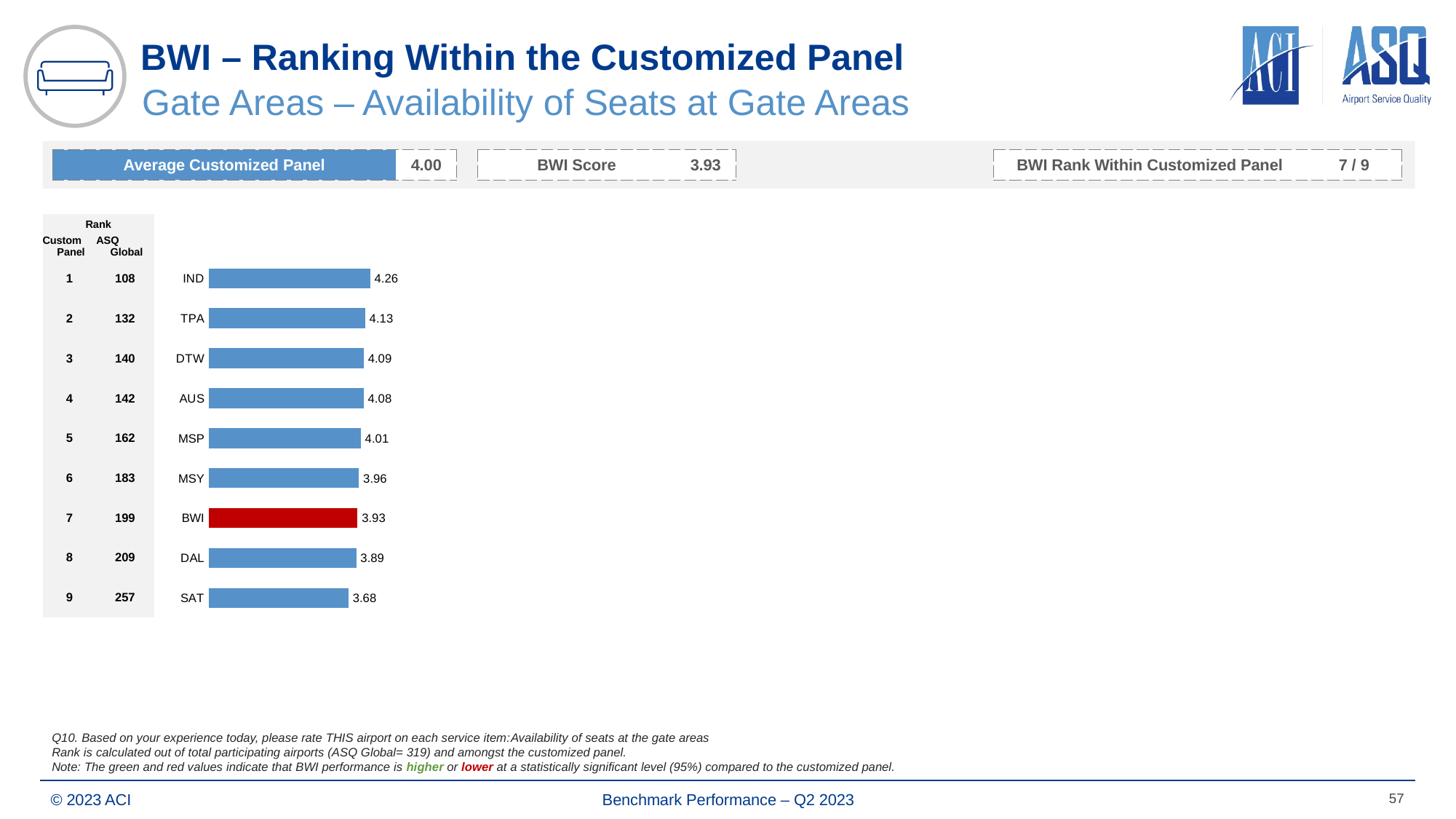
How many airports are shown in the bar chart? 9 What is the difference between the values for IND and BWI? 0.33 Which bar in the chart is coloured red? BWI What is the difference between the values for BWI and SAT? 0.25 Which has a larger value, TPA or DAL? TPA What kind of chart is shown on the slide? bar chart Which airport has the lowest value in the bar chart? SAT What is the value for IND in the bar chart? 4.26 What is the value for BWI in the bar chart? 3.93 Do the values rise or fall going down the bar chart from IND to SAT? fall What is the value for SAT in the bar chart? 3.68 Which airport has the highest value in the bar chart? IND